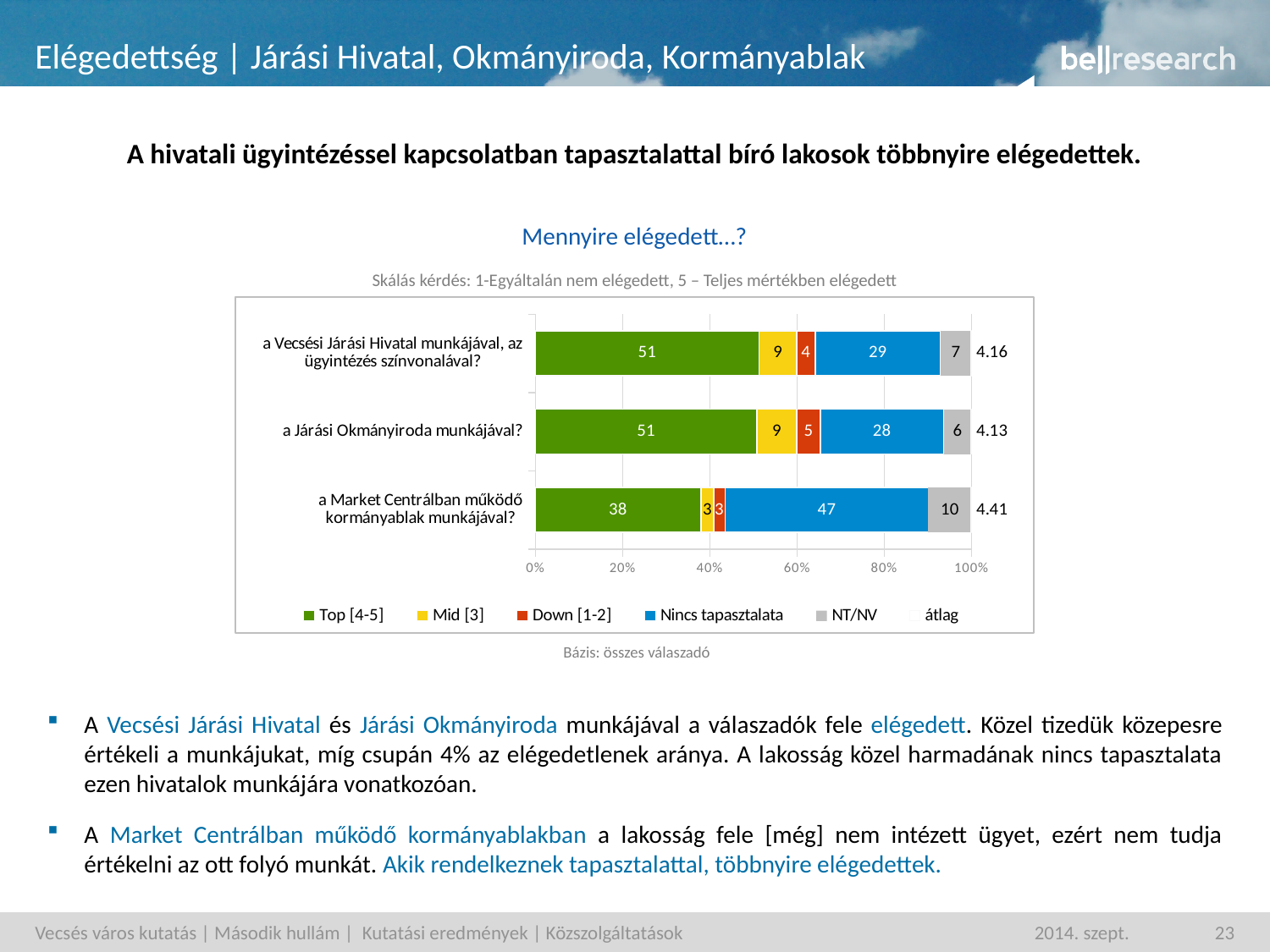
What is the difference between the "Nincs tapasztalata" values for "a Market Centrálban működő kormányablak munkájával?" and "a Járási Okmányiroda munkájával?"? 19 How many entries does the chart legend list? 6 Which category has the lowest Top [4-5] value? a Market Centrálban működő kormányablak munkájával? What kind of chart is shown on the slide? Stacked bar chart What is the átlag (average) shown for "a Vecsési Járási Hivatal munkájával, az ügyintézés színvonalával?"? 4.16 Which is larger: the Down [1-2] value for "a Járási Okmányiroda munkájával?" or for "a Vecsési Járási Hivatal munkájával, az ügyintézés színvonalával?"? a Járási Okmányiroda munkájával? What is the NT/NV value for "a Market Centrálban működő kormányablak munkájával?"? 10 What is the title of the chart? Mennyire elégedett…? What is the "Nincs tapasztalata" value for "a Market Centrálban működő kormányablak munkájával?"? 47 How many categories (bars) does the chart show? 3 What is the Top [4-5] value for "a Járási Okmányiroda munkájával?"? 51 Which category has the highest átlag (average) value? a Market Centrálban működő kormányablak munkájával?